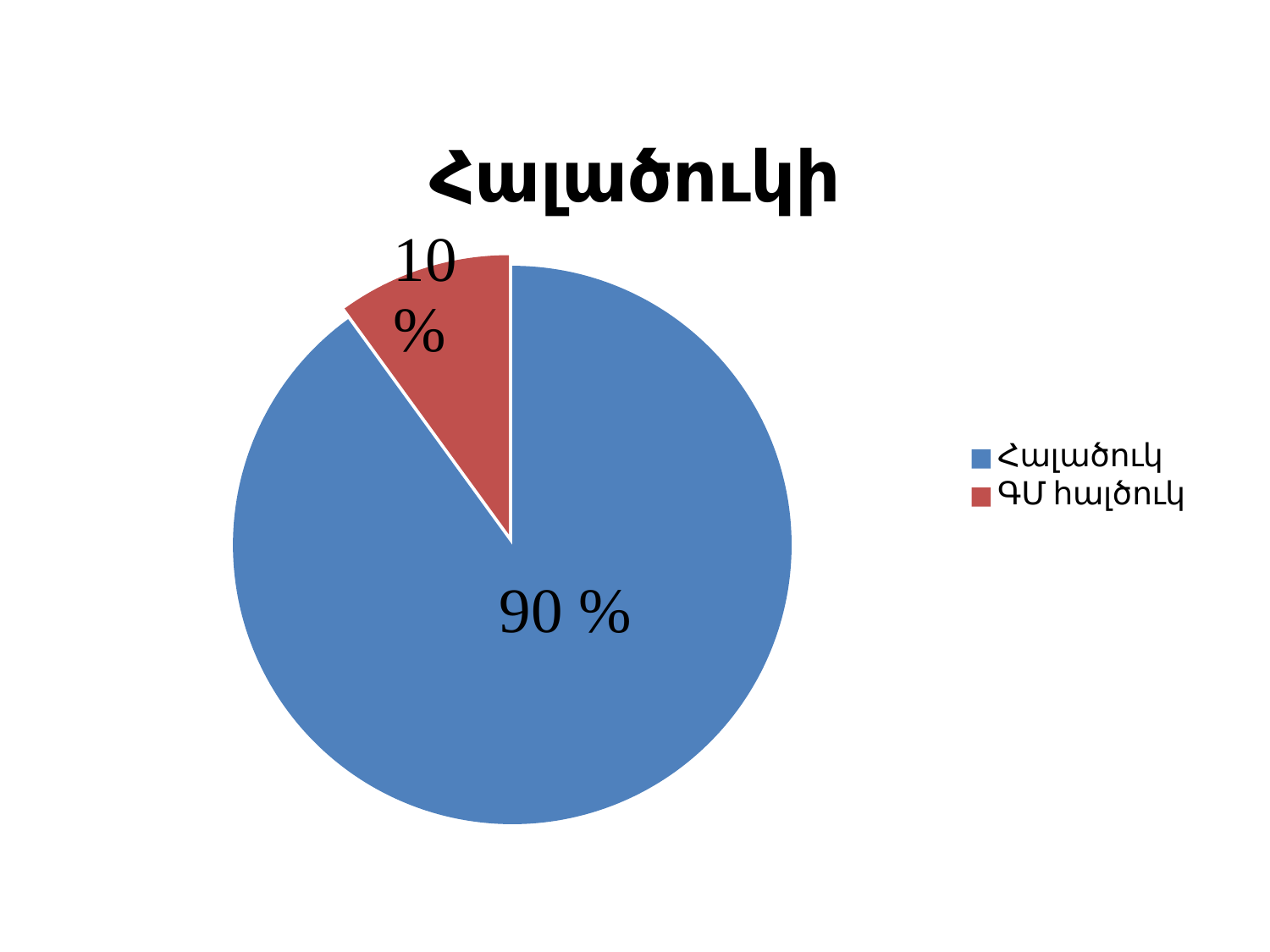
Which is larger, the Հալածուկ slice or the ԳՄ հալծուկ slice? Հալածուկ What is the title of the chart? Հալածուկի What kind of chart is shown on the slide? pie chart What is the difference in percentage points between the Հալածուկ slice and the ԳՄ հալծուկ slice? 80 How many entries does the legend list? 2 Which slice is the smallest in the pie chart? ԳՄ հալծուկ What share of the pie does the ԳՄ հալծուկ slice take? 10 % How many slices does the pie chart have? 2 What colour is the ԳՄ հալծուկ slice? red Which slice is the largest in the pie chart? Հալածուկ What share of the pie does the Հալածուկ slice take? 90 %